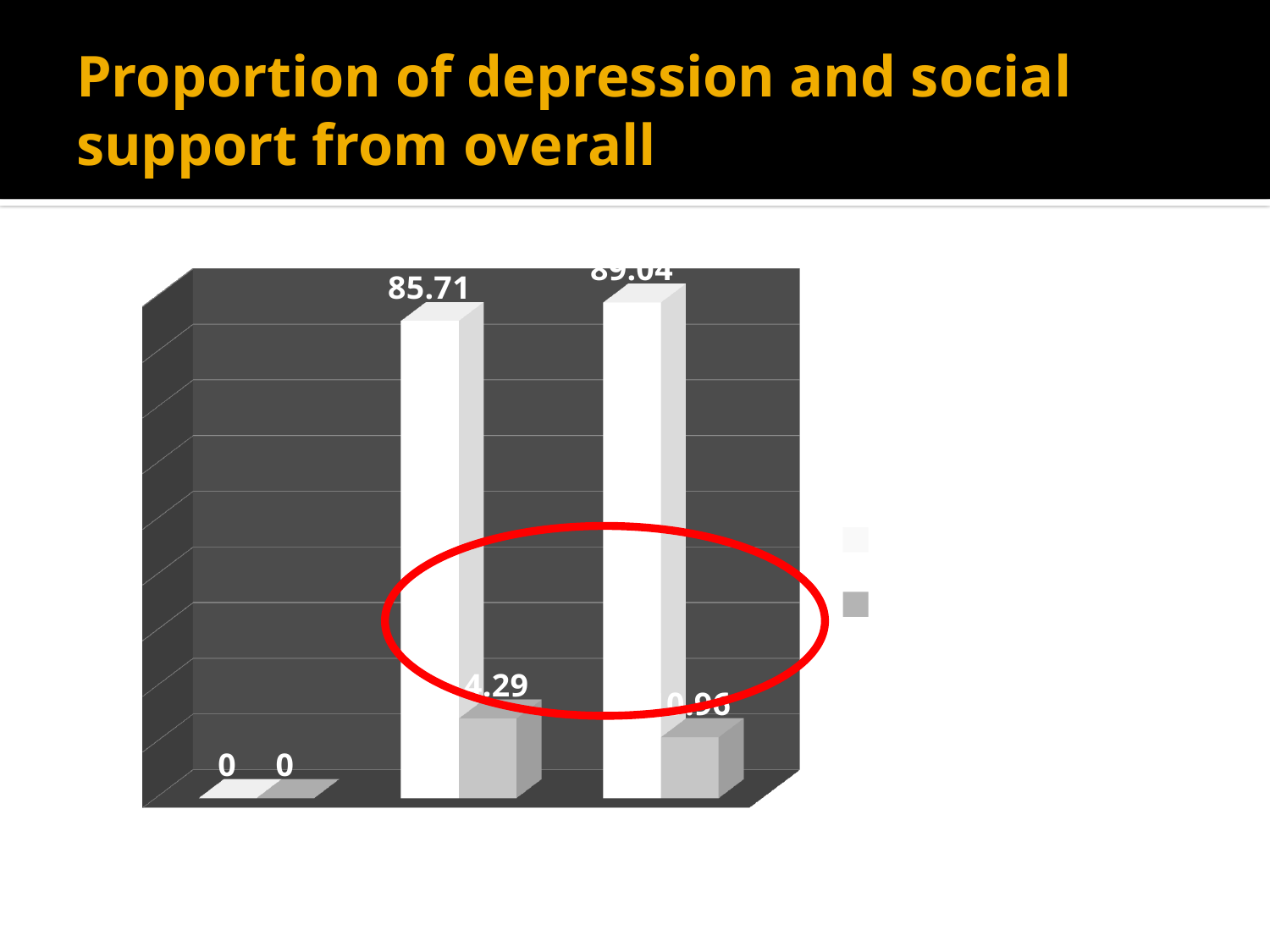
Do the white bars rise or fall from the leftmost group to the rightmost group? rise What is the value labelled on the grey bar in the middle group? 14.29 What kind of chart is shown on the slide? bar chart What is the value labelled on the white bar in the middle group? 85.71 What values are labelled on the two bars in the leftmost group? 0 and 0 What is the title of the slide containing the chart? Proportion of depression and social support from overall How many series does the legend show? 2 How many groups of bars are plotted in the chart? 3 What colour is the oval annotation drawn over the chart? red In the middle group, which bar is larger, the white bar or the grey bar? the white bar